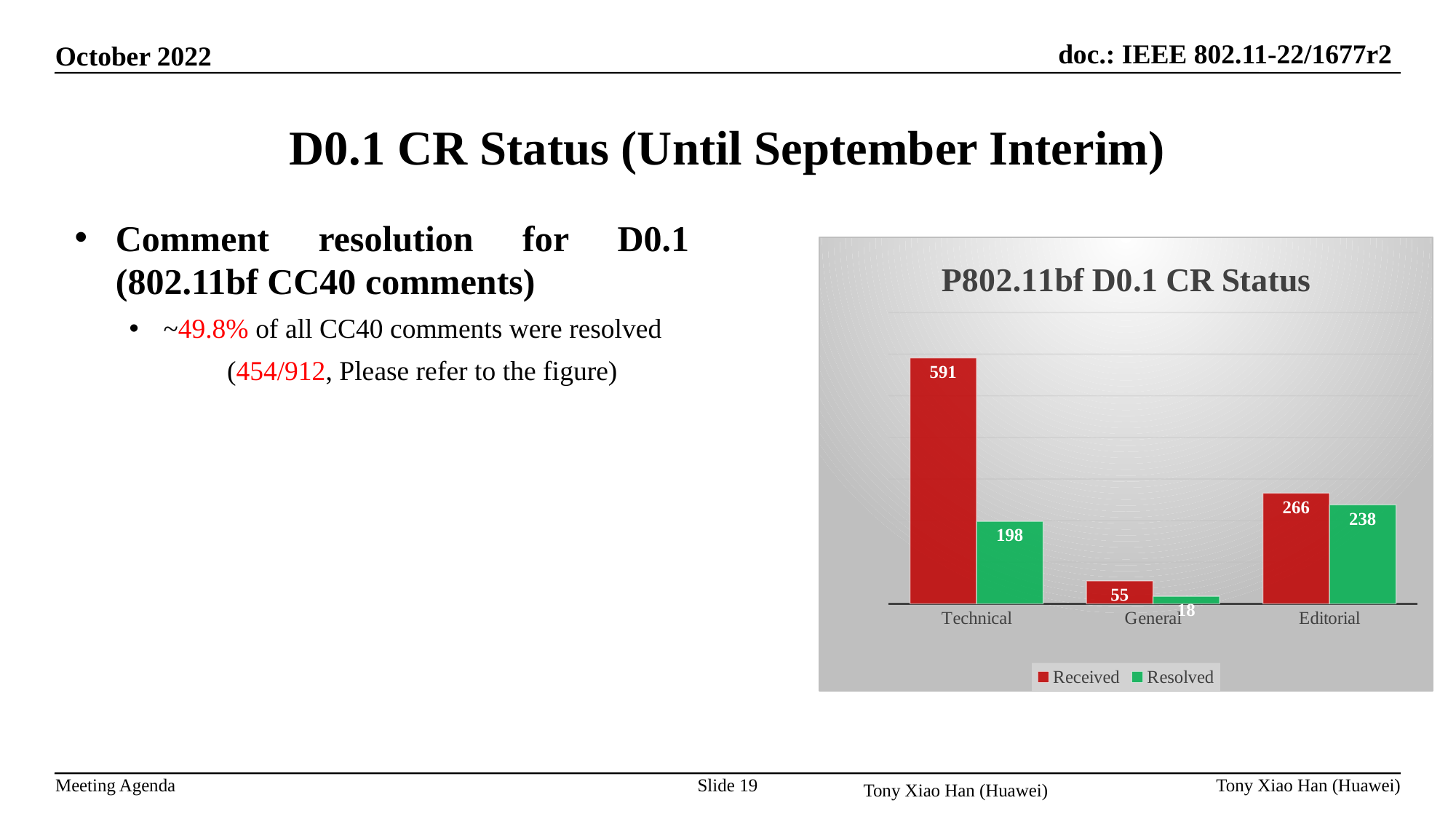
Which category has the lowest Resolved value? General Which category has the highest Received value? Technical How many series does the legend list? 2 Which is larger, the Resolved value for Technical or the Resolved value for Editorial? Editorial What is the Resolved value for Editorial? 238 What is the title of the chart? P802.11bf D0.1 CR Status What is the difference between Received and Resolved for Technical? 393 What is the Received value for Technical? 591 What kind of chart is shown? bar chart How many categories are shown on the x axis? 3 What is the difference between Received and Resolved for Editorial? 28 What is the Resolved value for General? 18